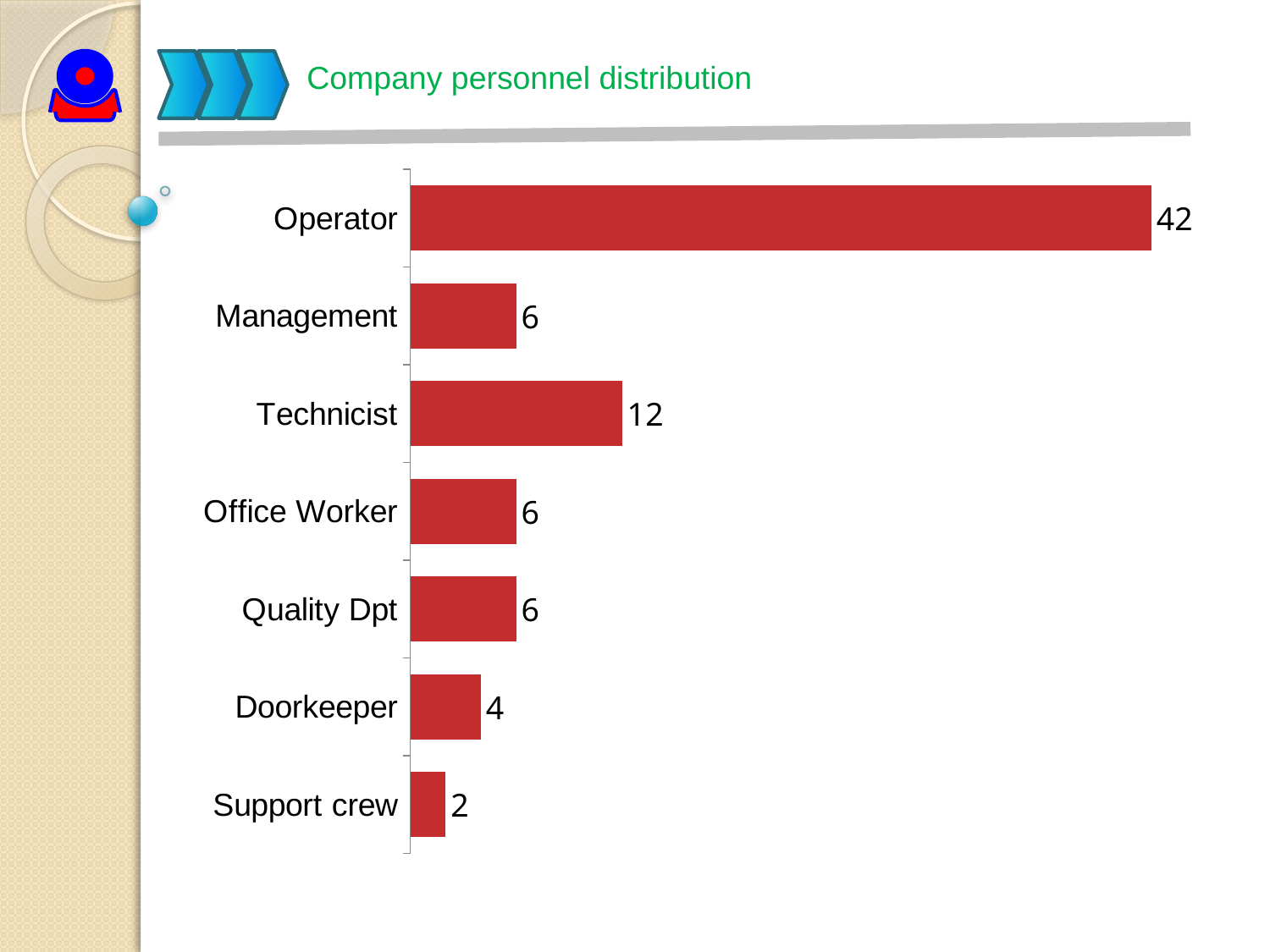
What is the title of the slide containing the chart? Company personnel distribution How many categories are shown in the chart? 7 Which category has the highest value? Operator What is the value for Support crew? 2 Which is larger, the value for Technicist or the value for Management? Technicist What kind of chart is shown on the slide? Bar chart What is the value for Doorkeeper? 4 What is the difference between the values for Operator and Technicist? 30 Which category has the lowest value? Support crew What is the value for Technicist? 12 What is the value for Operator? 42 What is the value for Quality Dpt? 6